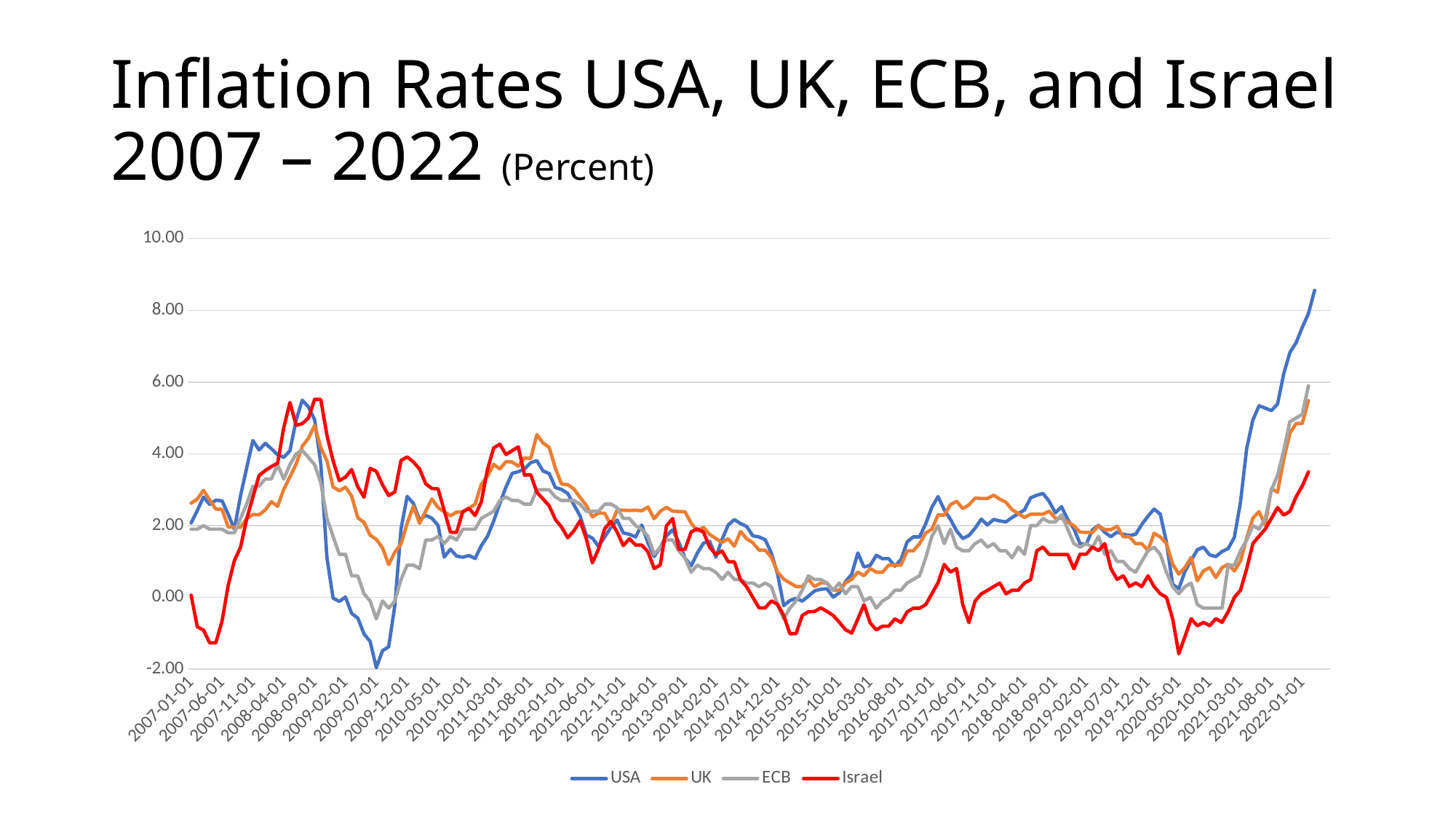
How many series does the legend list? 4 Which series has the lowest value at the right end of the chart (2022)? Israel Which series is plotted in red? Israel Is the value for Israel at the right end of the chart greater or less than 4.00? less Which series reaches the lowest value anywhere on the chart? USA Is the value for USA at the right end of the chart greater or less than 8.00? greater Does the USA series rise or fall between 2021-03-01 and 2022-01-01? rise Is the value for Israel around 2007-06-01 greater or less than 0.00? less What kind of chart is shown on the slide? line chart Which series has the highest value at the right end of the chart (2022)? USA What is the title of the chart on the slide? Inflation Rates USA, UK, ECB, and Israel 2007 – 2022 (Percent)